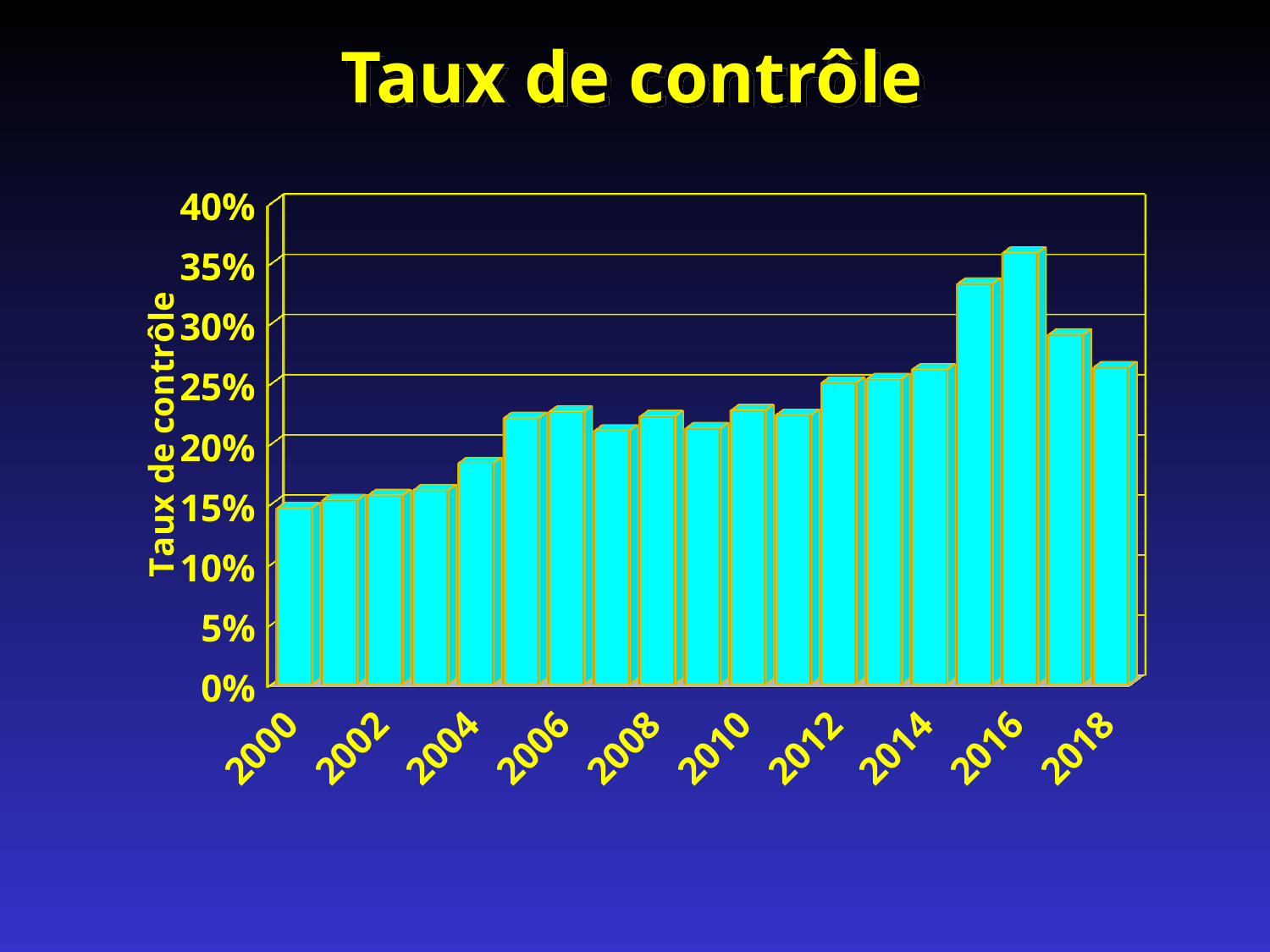
How many bars (years) are plotted in the chart? 19 Does the taux de contrôle generally rise or fall from 2000 to 2016? rise Which year has a higher taux de contrôle, 2015 or 2016? 2016 What is the label of the vertical axis? Taux de contrôle What is the title of the chart? Taux de contrôle Which year has the lowest taux de contrôle? 2000 Is the value for 2006 greater or less than 25%? less What kind of chart is shown on the slide? bar chart Is the value for 2000 greater or less than 20%? less Is the value for 2016 greater or less than 30%? greater Which year has the highest taux de contrôle? 2016